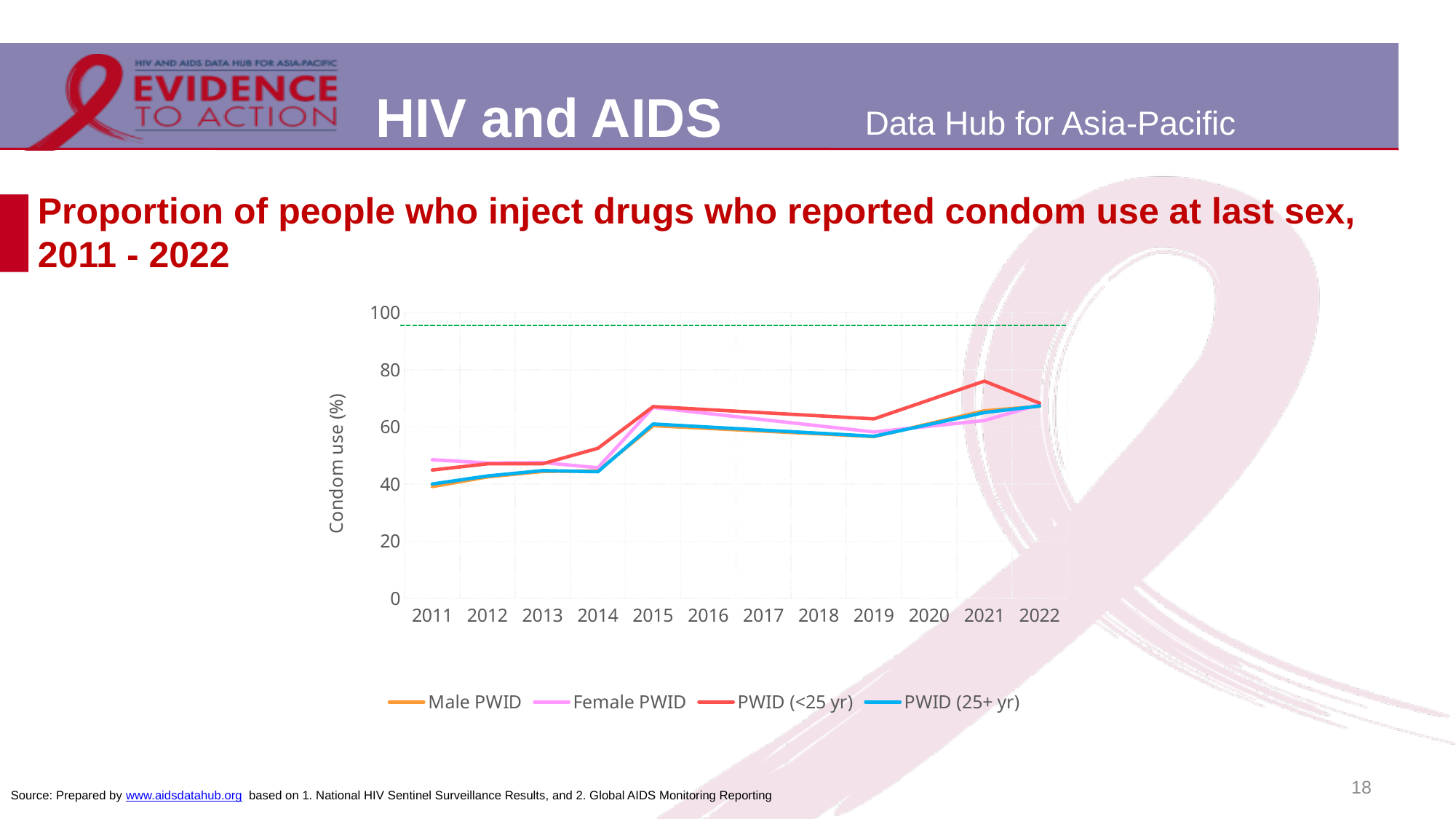
Does the Male PWID series rise or fall between 2011 and 2015? Rise What is the label of the y axis? Condom use (%) What kind of chart is shown on the slide? Line chart Is the value for PWID (25+ yr) in 2019 greater or less than 60? less Which series is higher in 2015, PWID (<25 yr) or PWID (25+ yr)? PWID (<25 yr) How many series does the legend list? 4 How many years are shown on the x axis? 12 Is the value for Male PWID in 2022 greater or less than 80? less Which series has the highest value in 2021? PWID (<25 yr) Is the value for Female PWID in 2011 greater or less than 40? greater In which year does the PWID (<25 yr) series reach its highest value? 2021